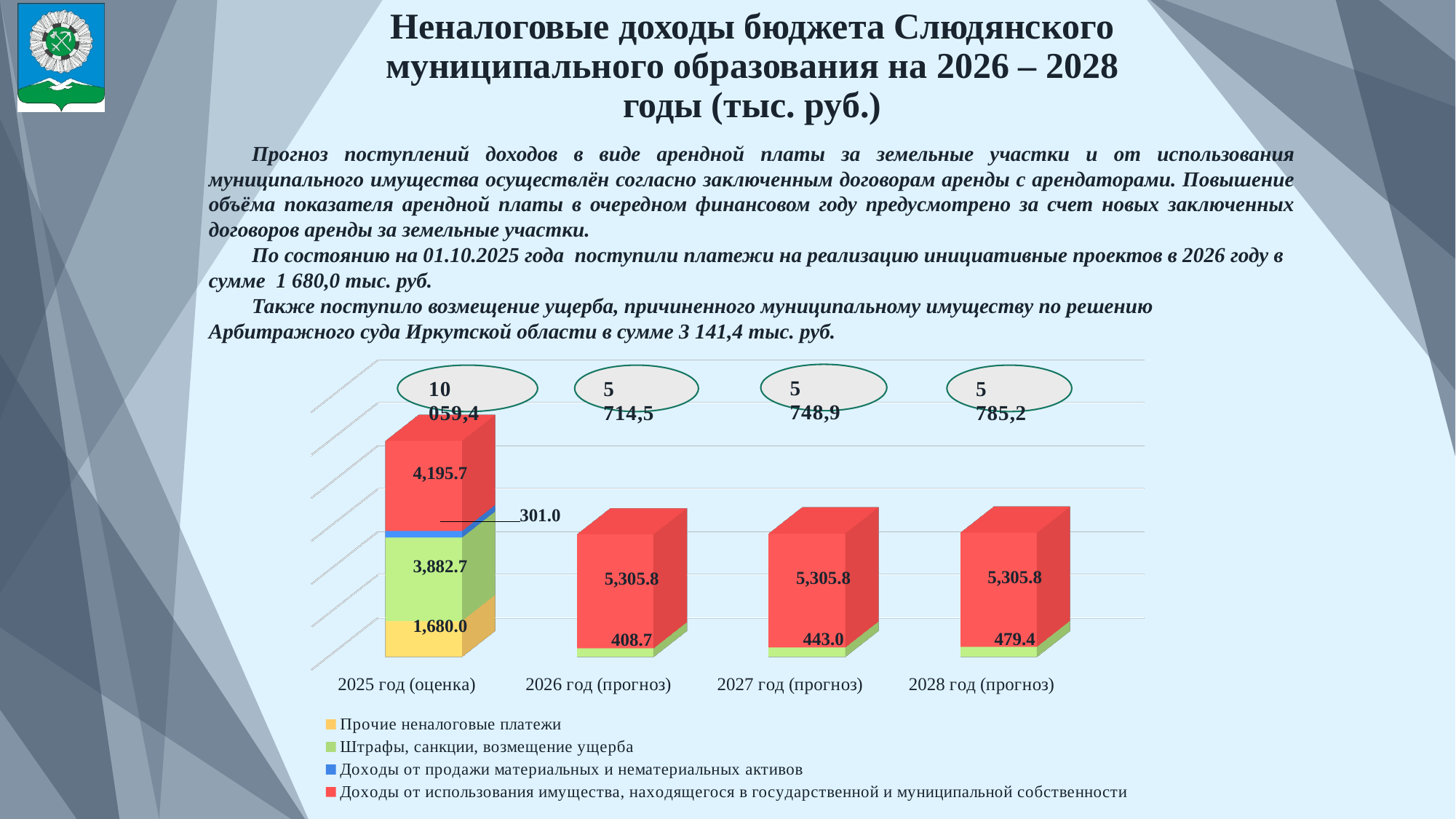
How many year categories are shown on the x axis of the chart? 4 What is the value of 'Доходы от использования имущества, находящегося в государственной и муниципальной собственности' for 2025 год (оценка)? 4,195.7 What type of chart is shown on the slide? stacked bar chart What is the total shown above the bar for 2026 год (прогноз)? 5 714,5 What is the value of 'Прочие неналоговые платежи' for 2025 год (оценка)? 1,680.0 What is the difference between the 'Штрафы, санкции, возмещение ущерба' values for 2028 год (прогноз) and 2026 год (прогноз)? 70.7 Which year has the lowest value for 'Штрафы, санкции, возмещение ущерба'? 2026 год (прогноз) How many series does the chart legend list? 4 What is the value of 'Штрафы, санкции, возмещение ущерба' for 2027 год (прогноз)? 443.0 Which year has the highest total non-tax revenue in the chart? 2025 год (оценка) What is the value of 'Доходы от продажи материальных и нематериальных активов' for 2025 год (оценка)? 301.0 Does the value of 'Штрафы, санкции, возмещение ущерба' rise or fall from 2026 год (прогноз) to 2028 год (прогноз)? rise